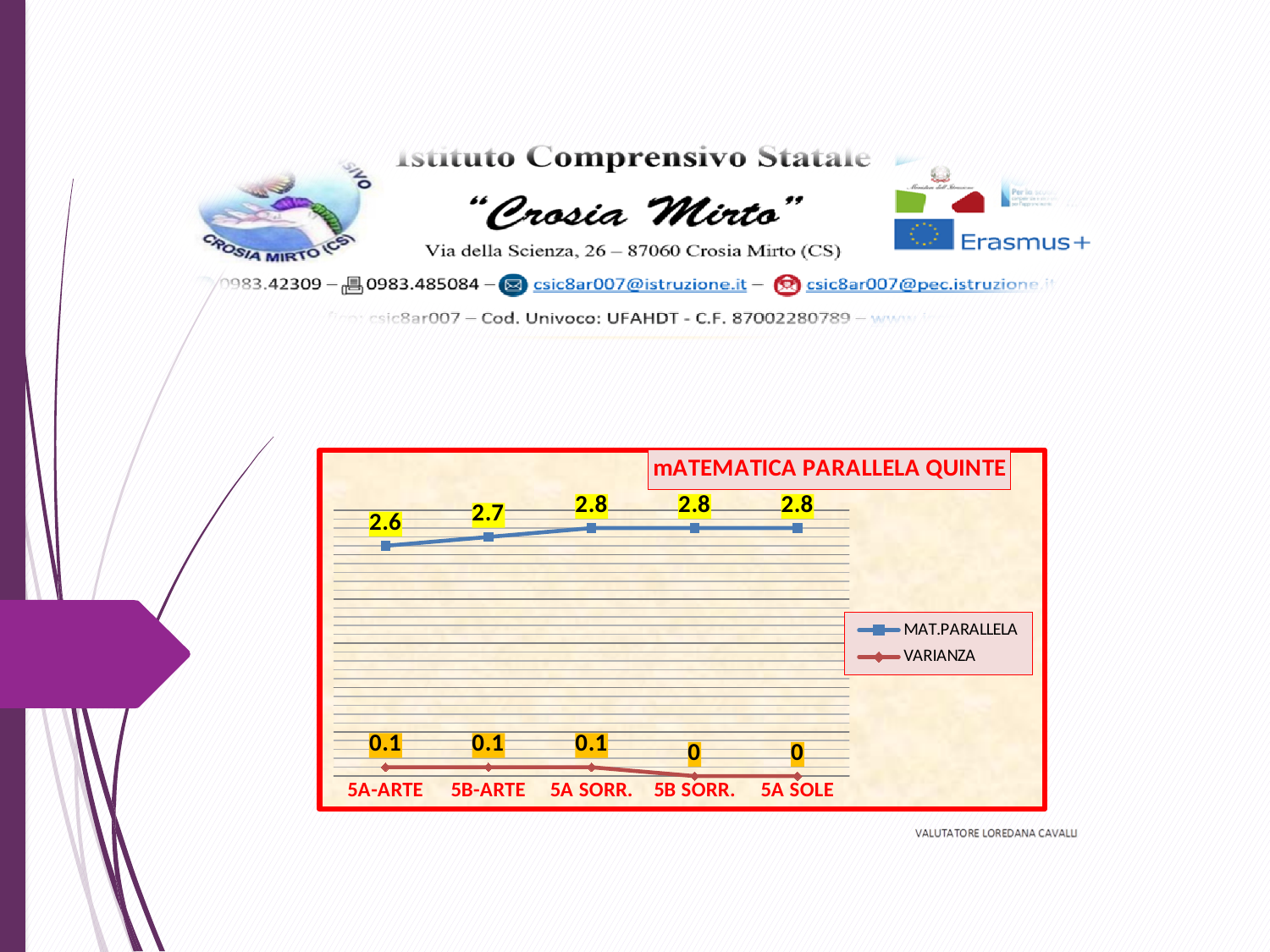
What kind of chart is shown? line chart What is the MAT.PARALLELA value for 5B-ARTE? 2.7 Which category has the lowest MAT.PARALLELA value? 5A-ARTE What is the VARIANZA value for 5B SORR.? 0 Which is larger, the MAT.PARALLELA value for 5B-ARTE or for 5A-ARTE? 5B-ARTE How many categories are shown on the x axis? 5 What is the VARIANZA value for 5A-ARTE? 0.1 What is the title of the chart? mATEMATICA PARALLELA QUINTE What is the MAT.PARALLELA value for 5A-ARTE? 2.6 What is the difference between the MAT.PARALLELA values for 5A SORR. and 5A-ARTE? 0.2 How many series does the legend list? 2 Does the MAT.PARALLELA series rise or fall from 5A-ARTE to 5A SORR.? rise